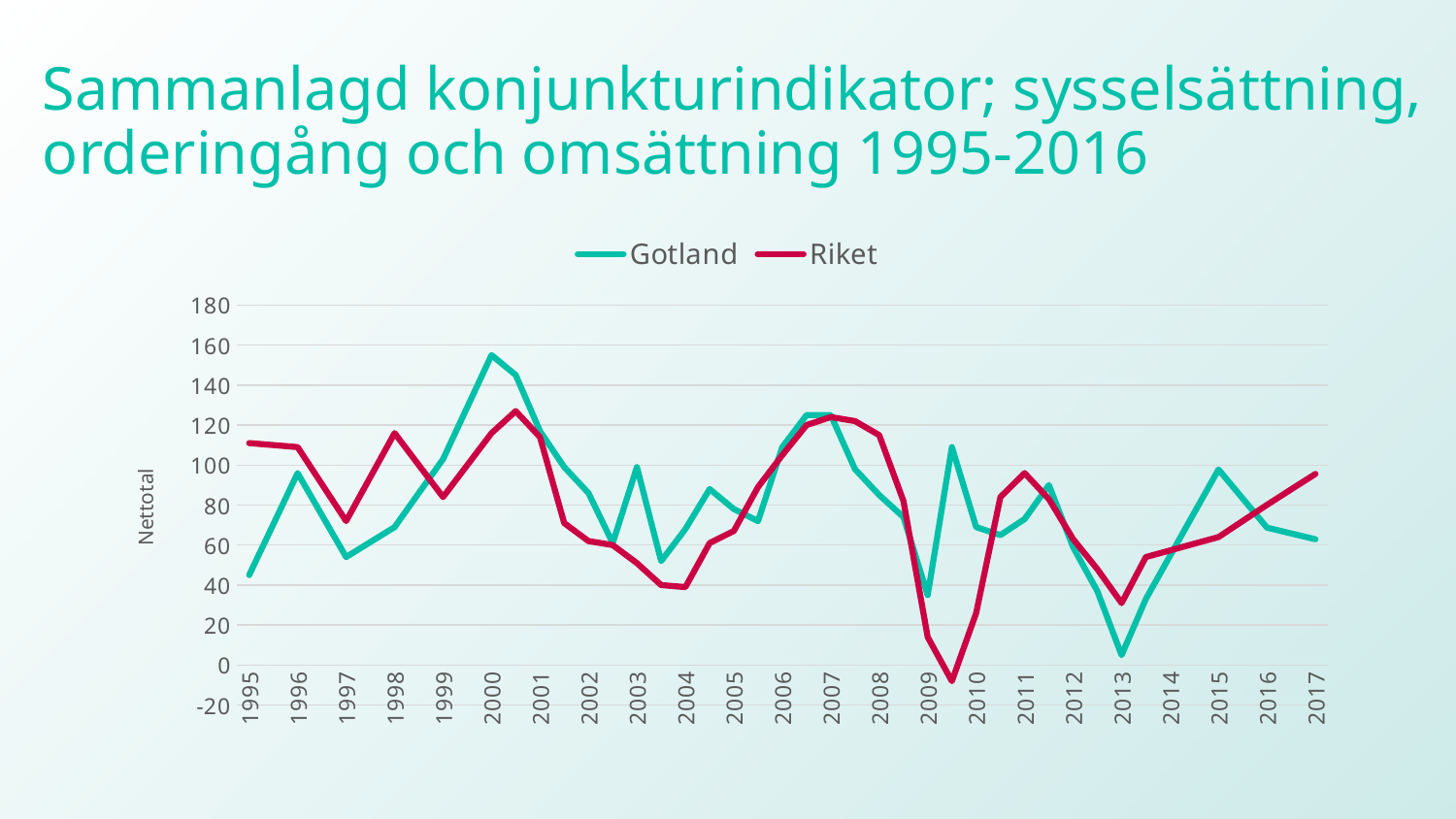
Is the value for Gotland in 2013 greater or less than 20? less What are the two series named in the legend? Gotland and Riket In which year does the Gotland line reach its highest value? 2000 How many year labels are shown along the x axis? 23 Is the value for Riket in 2004 greater or less than 60? less Which series has the higher value in 2017, Gotland or Riket? Riket In which year does the Gotland line reach its lowest value? 2013 Is the value for Gotland in 2000 greater or less than 140? greater Does the Riket line rise or fall between 2013 and 2017? rise How many series does the legend list? 2 What is the label on the vertical axis? Nettotal What kind of chart is shown on the slide? line chart